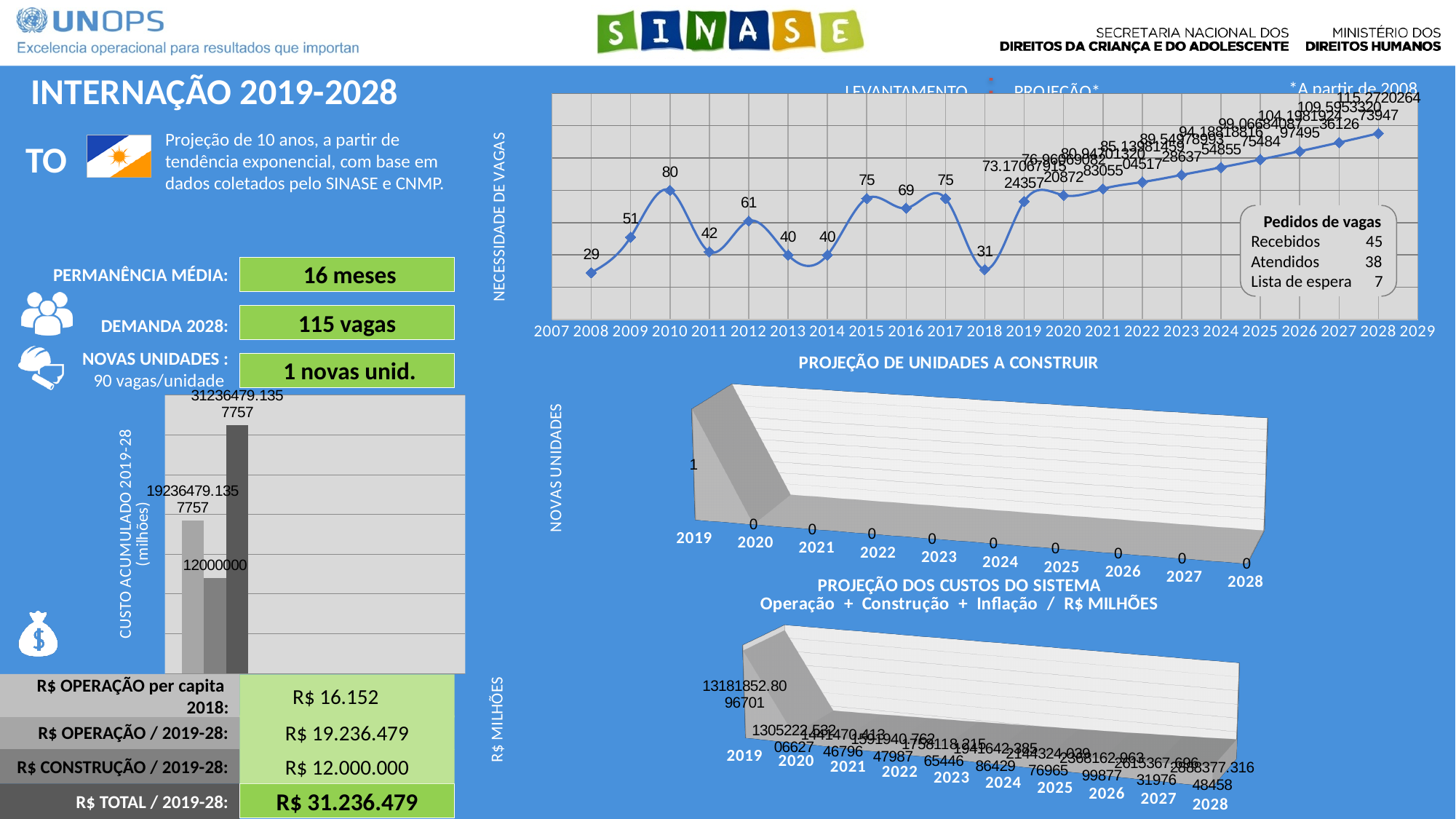
In the NECESSIDADE DE VAGAS line chart, what is the value for 2018? 31 In the PROJEÇÃO DE UNIDADES A CONSTRUIR chart, what is the value for 2019? 1 In the CUSTO ACUMULADO 2019-28 bar chart on the left, what is the value of the middle bar? 12000000 In the NECESSIDADE DE VAGAS line chart, which year has the lowest value in the LEVANTAMENTO series? 2008 In the NECESSIDADE DE VAGAS line chart, what is the value for 2010? 80 How many series does the legend of the NECESSIDADE DE VAGAS chart list? 2 In the NECESSIDADE DE VAGAS line chart, what is the difference between the values for 2010 and 2008? 51 In the NECESSIDADE DE VAGAS line chart, which year has the highest value in the LEVANTAMENTO series? 2010 In the NECESSIDADE DE VAGAS line chart, which year has the larger value, 2015 or 2016? 2015 In the NECESSIDADE DE VAGAS chart, do the projected values rise or fall from 2019 to 2028? rise What kind of chart is the NECESSIDADE DE VAGAS chart? line chart In the PROJEÇÃO DE UNIDADES A CONSTRUIR chart, what is the value for 2025? 0